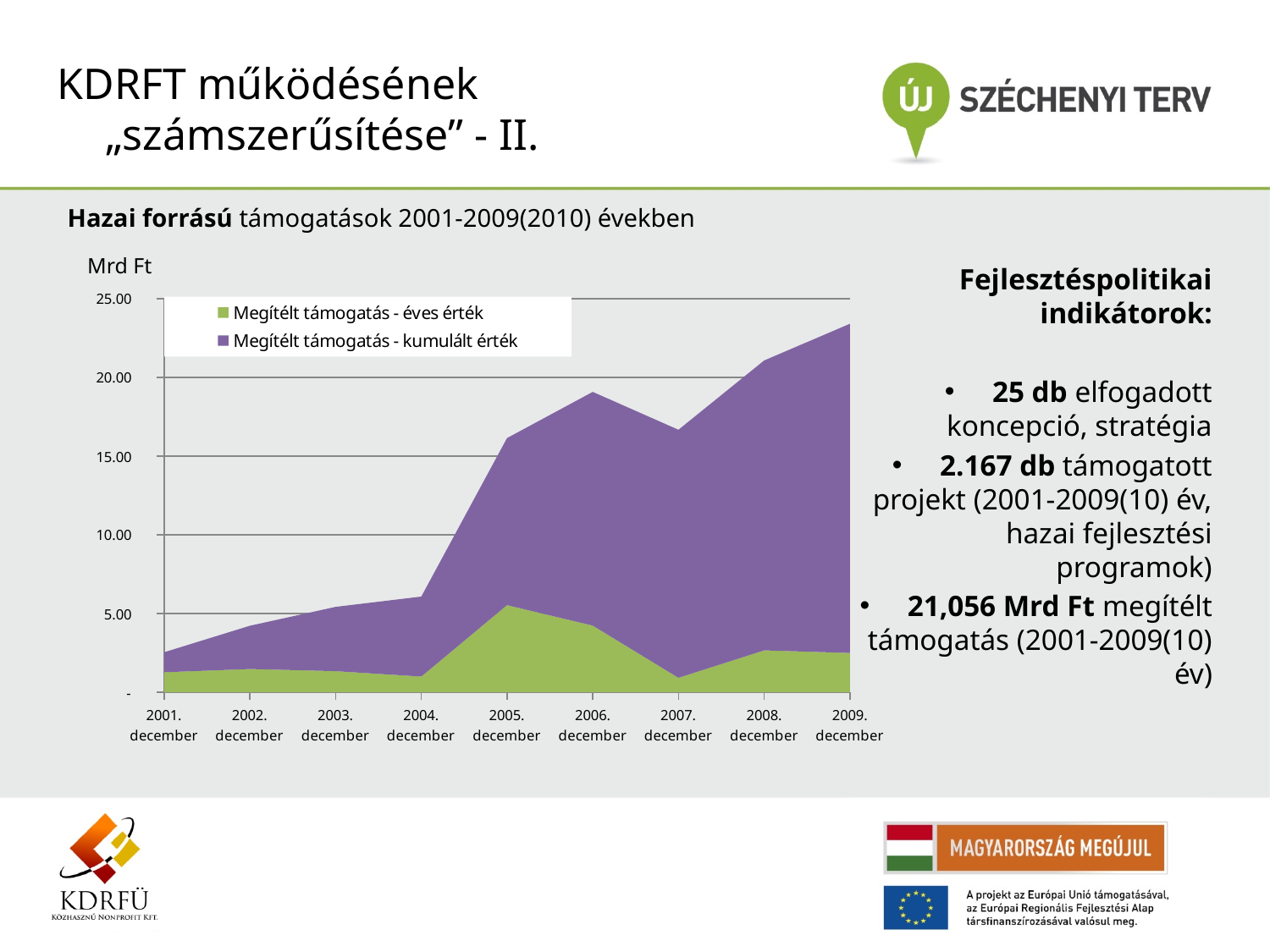
How many time points are shown along the x axis of the chart? 9 What kind of chart is shown on the slide? Area chart Does the 'Megítélt támogatás - kumulált érték' series rise or fall from 2001. december to 2006. december? Rise Is the value of 'Megítélt támogatás - kumulált érték' at 2009. december greater or less than 20.00? greater At which time point is the 'Megítélt támogatás - éves érték' series highest? 2005. december What unit is shown above the y axis of the chart? Mrd Ft Is the value of 'Megítélt támogatás - éves érték' at 2007. december greater or less than 5.00? less Is the value of 'Megítélt támogatás - kumulált érték' at 2001. december greater or less than 5.00? less At which time point is the 'Megítélt támogatás - kumulált érték' series highest? 2009. december How many series does the chart legend list? 2 Which series in the chart is shown in purple? Megítélt támogatás - kumulált érték